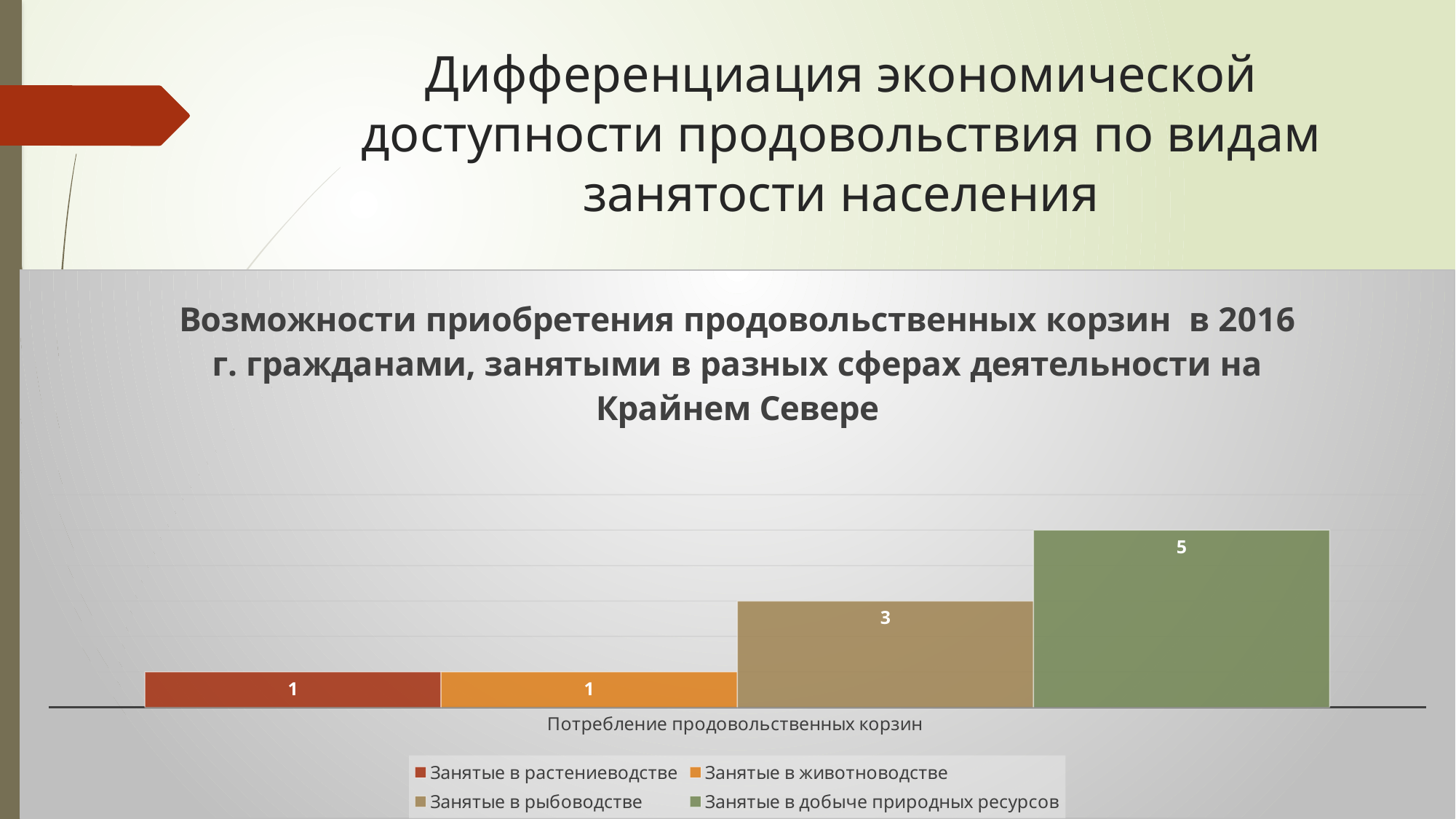
What is the difference between the values for Занятые в добыче природных ресурсов and Занятые в рыбоводстве? 2 What is the difference between the values for Занятые в рыбоводстве and Занятые в растениеводстве? 2 What value is shown for Занятые в добыче природных ресурсов? 5 What is the label of the category on the x axis? Потребление продовольственных корзин How many series does the legend list? 4 Which series has the highest value? Занятые в добыче природных ресурсов What kind of chart is shown on the slide? Bar chart What colour is the bar for Занятые в добыче природных ресурсов? Green Which is larger: the value for Занятые в рыбоводстве or the value for Занятые в животноводстве? Занятые в рыбоводстве What value is shown for Занятые в растениеводстве? 1 What value is shown for Занятые в рыбоводстве? 3 What value is shown for Занятые в животноводстве? 1